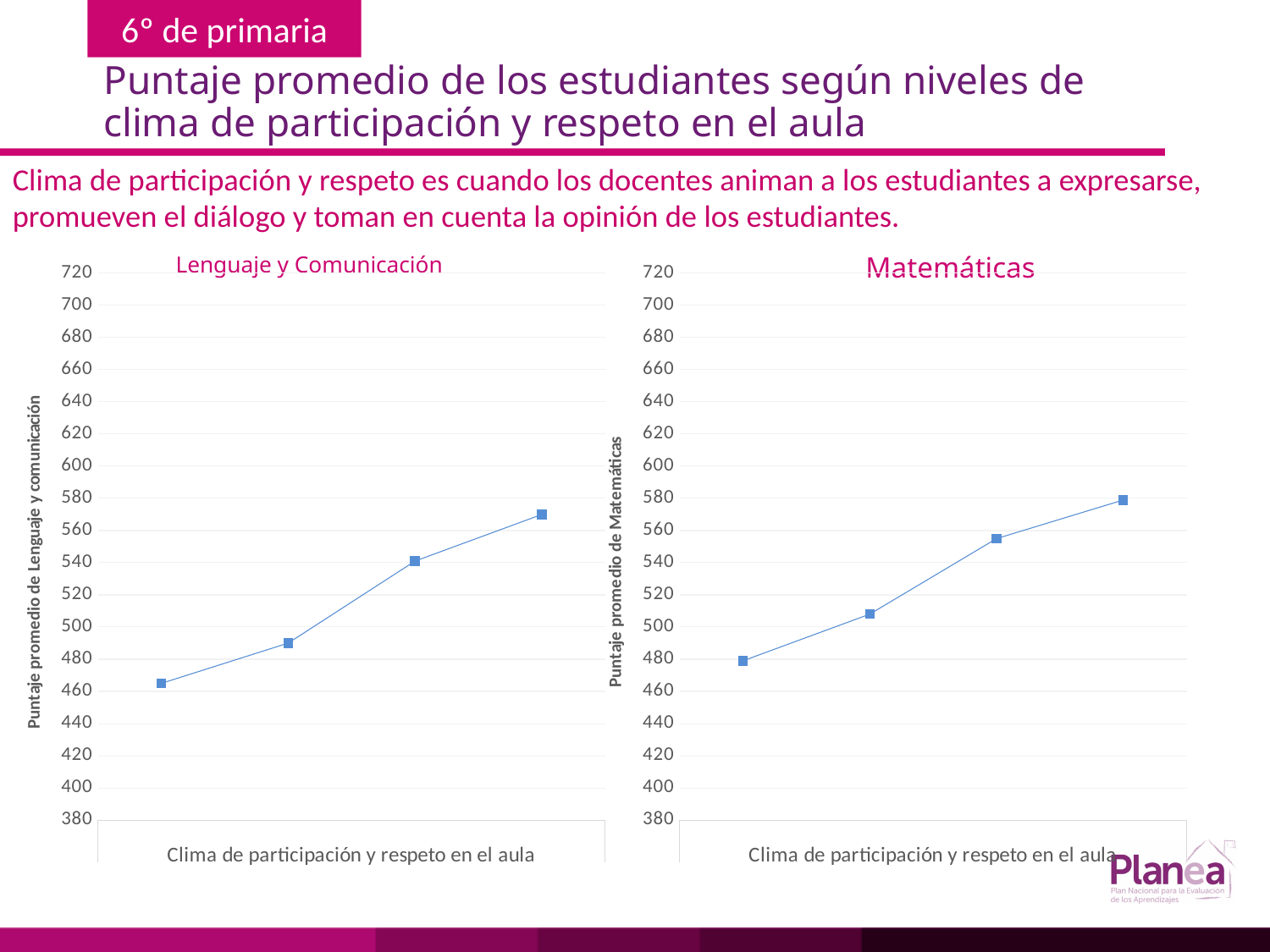
How many data points are plotted in the Lenguaje y Comunicación chart? 4 How many data points are plotted in the Matemáticas chart? 4 In the Lenguaje y Comunicación chart, is the value of the leftmost point greater or less than 480? less What is the title of the horizontal axis in the Lenguaje y Comunicación chart? Clima de participación y respeto en el aula In the Matemáticas chart, do the values rise or fall from left to right along the x axis? rise What kind of chart is the Matemáticas chart? line chart In the Lenguaje y Comunicación chart, is the value of the rightmost point greater or less than 560? greater In the Lenguaje y Comunicación chart, do the values rise or fall from left to right along the x axis? rise In the Matemáticas chart, is the value of the rightmost point greater or less than 600? less What kind of chart is the Lenguaje y Comunicación chart? line chart What is the title of the vertical axis in the Matemáticas chart? Puntaje promedio de Matemáticas